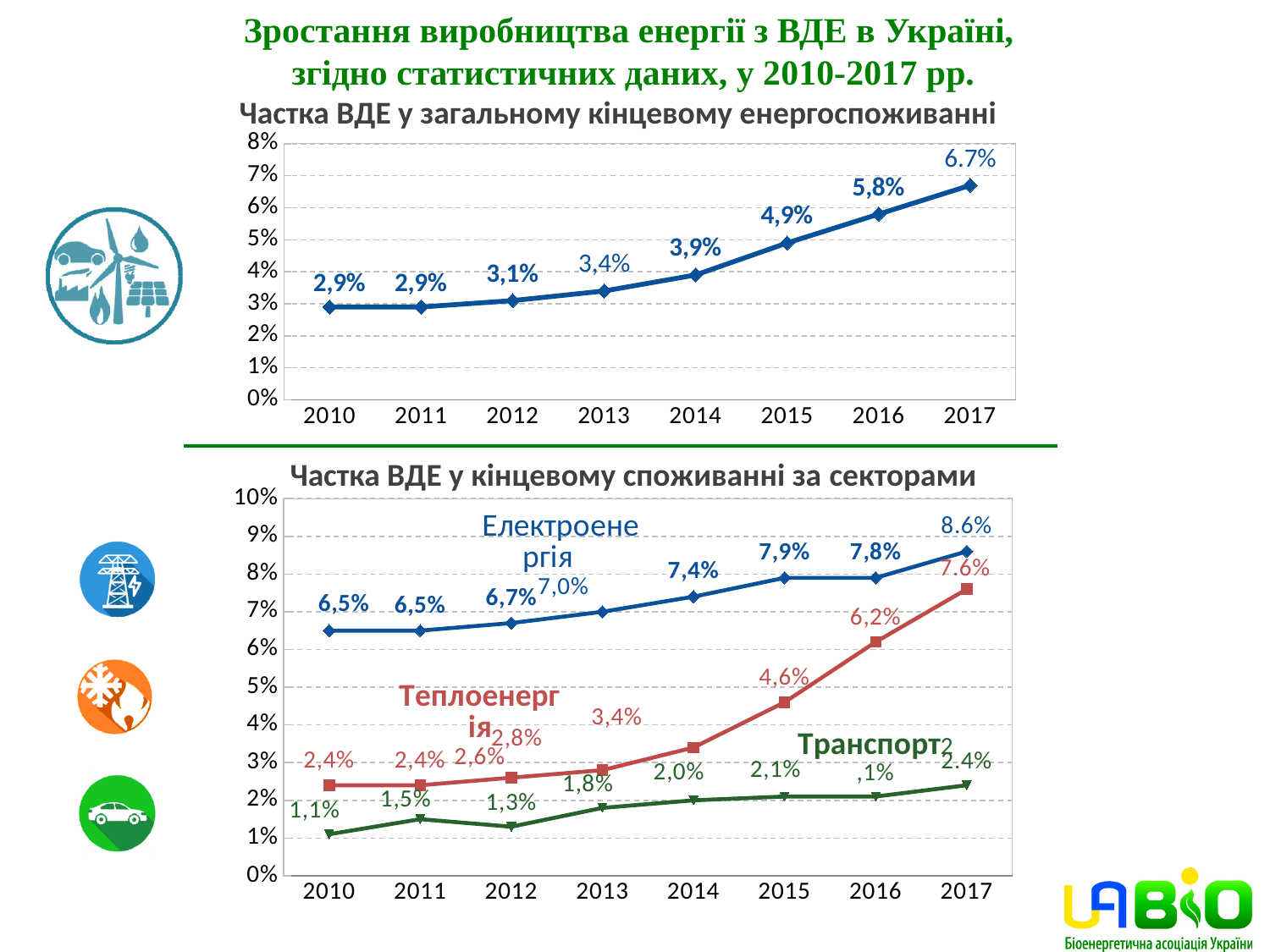
In the top chart 'Частка ВДЕ у загальному кінцевому енергоспоживанні', what is the value for 2017? 6.7% In the bottom chart 'Частка ВДЕ у кінцевому споживанні за секторами', how many series are plotted? 3 In the bottom chart 'Частка ВДЕ у кінцевому споживанні за секторами', what is the value for Теплоенергія in 2016? 6,2% In the top chart 'Частка ВДЕ у загальному кінцевому енергоспоживанні', which year has the lowest value? 2010 and 2011 (2,9%) In the bottom chart 'Частка ВДЕ у кінцевому споживанні за секторами', which is larger in 2015: Електроенергія or Теплоенергія? Електроенергія What kind of chart is the bottom chart 'Частка ВДЕ у кінцевому споживанні за секторами'? line chart In the top chart 'Частка ВДЕ у загальному кінцевому енергоспоживанні', what is the value for 2014? 3,9% In the bottom chart 'Частка ВДЕ у кінцевому споживанні за секторами', what is the difference between Електроенергія and Транспорт in 2010? 5,4% In the bottom chart 'Частка ВДЕ у кінцевому споживанні за секторами', which series has the highest value in 2017? Електроенергія In the top chart 'Частка ВДЕ у загальному кінцевому енергоспоживанні', how many years are plotted? 8 In the top chart 'Частка ВДЕ у загальному кінцевому енергоспоживанні', do the values rise or fall from 2010 to 2017? rise In the bottom chart 'Частка ВДЕ у кінцевому споживанні за секторами', what is the value for Транспорт in 2013? 1,8%